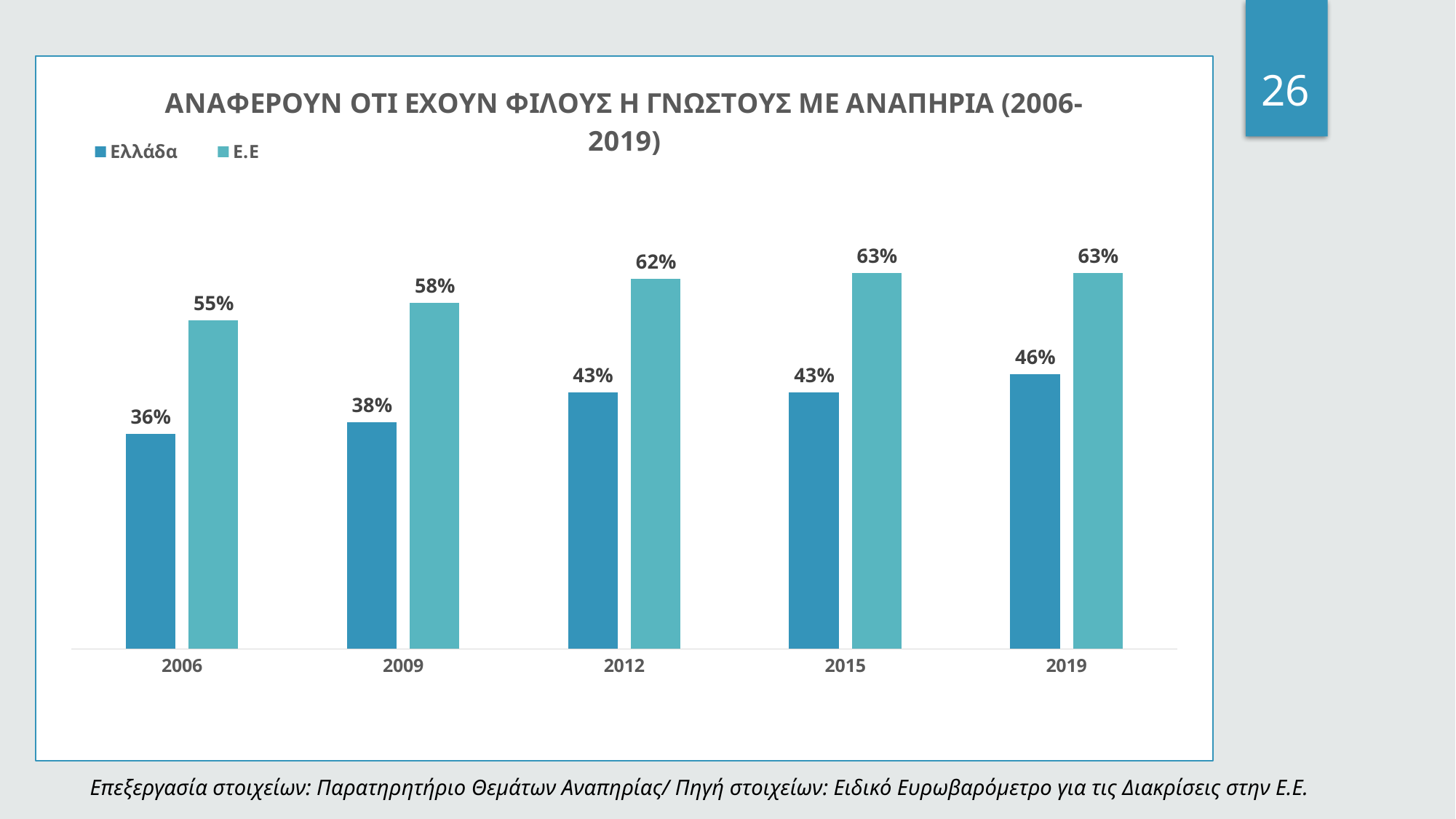
What is the value for Ελλάδα in 2006? 36% In which year is the Ελλάδα value highest? 2019 In which year is the Ελλάδα value lowest? 2006 What is the value for Ελλάδα in 2019? 46% Do the Ε.Ε values rise or fall from 2006 to 2019? Rise Which is larger in 2009, the Ελλάδα value or the Ε.Ε value? Ε.Ε How many years are shown on the x axis? 5 How many series does the legend list? 2 What is the difference between the Ε.Ε and Ελλάδα values in 2015? 20% What kind of chart is shown on the slide? Bar chart What is the value for Ε.Ε in 2012? 62% What are the two series listed in the legend? Ελλάδα and Ε.Ε